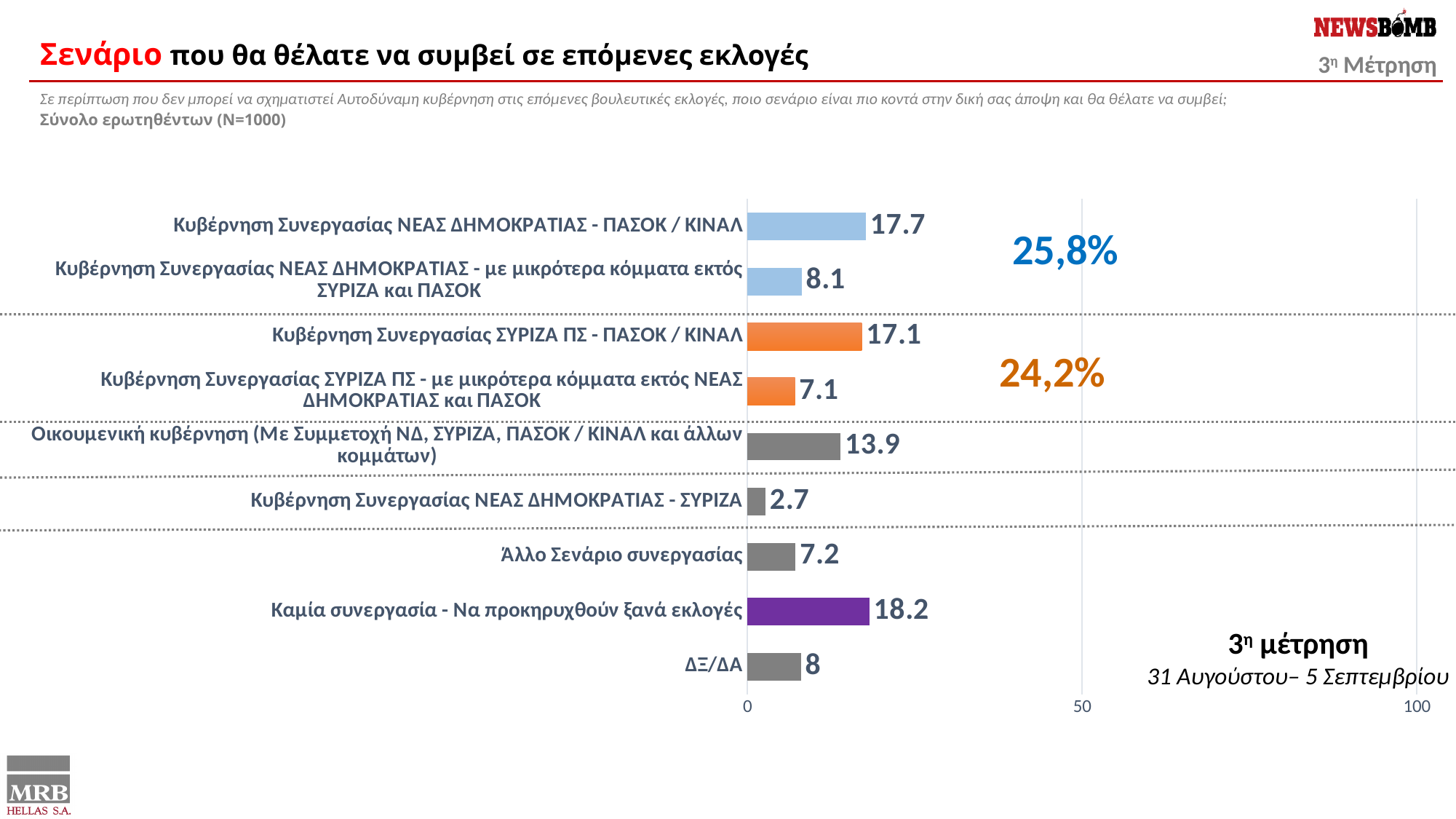
What is the value for "ΔΞ/ΔΑ"? 8 Which category has the lowest value? Κυβέρνηση Συνεργασίας ΝΕΑΣ ΔΗΜΟΚΡΑΤΙΑΣ - ΣΥΡΙΖΑ What is the value for "Καμία συνεργασία - Να προκηρυχθούν ξανά εκλογές"? 18.2 What is the value for "Οικουμενική κυβέρνηση (Με Συμμετοχή ΝΔ, ΣΥΡΙΖΑ, ΠΑΣΟΚ / ΚΙΝΑΛ και άλλων κομμάτων)"? 13.9 What is the combined percentage shown next to the two orange bars? 24,2% Is the value for "Καμία συνεργασία - Να προκηρυχθούν ξανά εκλογές" greater or less than 50? less What is the value for "Κυβέρνηση Συνεργασίας ΝΕΑΣ ΔΗΜΟΚΡΑΤΙΑΣ - ΠΑΣΟΚ / ΚΙΝΑΛ"? 17.7 Which category has the highest value? Καμία συνεργασία - Να προκηρυχθούν ξανά εκλογές What kind of chart is shown on the slide? bar chart Which is larger: the value for "Κυβέρνηση Συνεργασίας ΝΕΑΣ ΔΗΜΟΚΡΑΤΙΑΣ - με μικρότερα κόμματα εκτός ΣΥΡΙΖΑ και ΠΑΣΟΚ" or the value for "Κυβέρνηση Συνεργασίας ΣΥΡΙΖΑ ΠΣ - με μικρότερα κόμματα εκτός ΝΕΑΣ ΔΗΜΟΚΡΑΤΙΑΣ και ΠΑΣΟΚ"? Κυβέρνηση Συνεργασίας ΝΕΑΣ ΔΗΜΟΚΡΑΤΙΑΣ - με μικρότερα κόμματα εκτός ΣΥΡΙΖΑ και ΠΑΣΟΚ How many categories are shown in the chart? 9 What is the difference between the values for "Κυβέρνηση Συνεργασίας ΝΕΑΣ ΔΗΜΟΚΡΑΤΙΑΣ - ΠΑΣΟΚ / ΚΙΝΑΛ" and "Κυβέρνηση Συνεργασίας ΣΥΡΙΖΑ ΠΣ - ΠΑΣΟΚ / ΚΙΝΑΛ"? 0.6